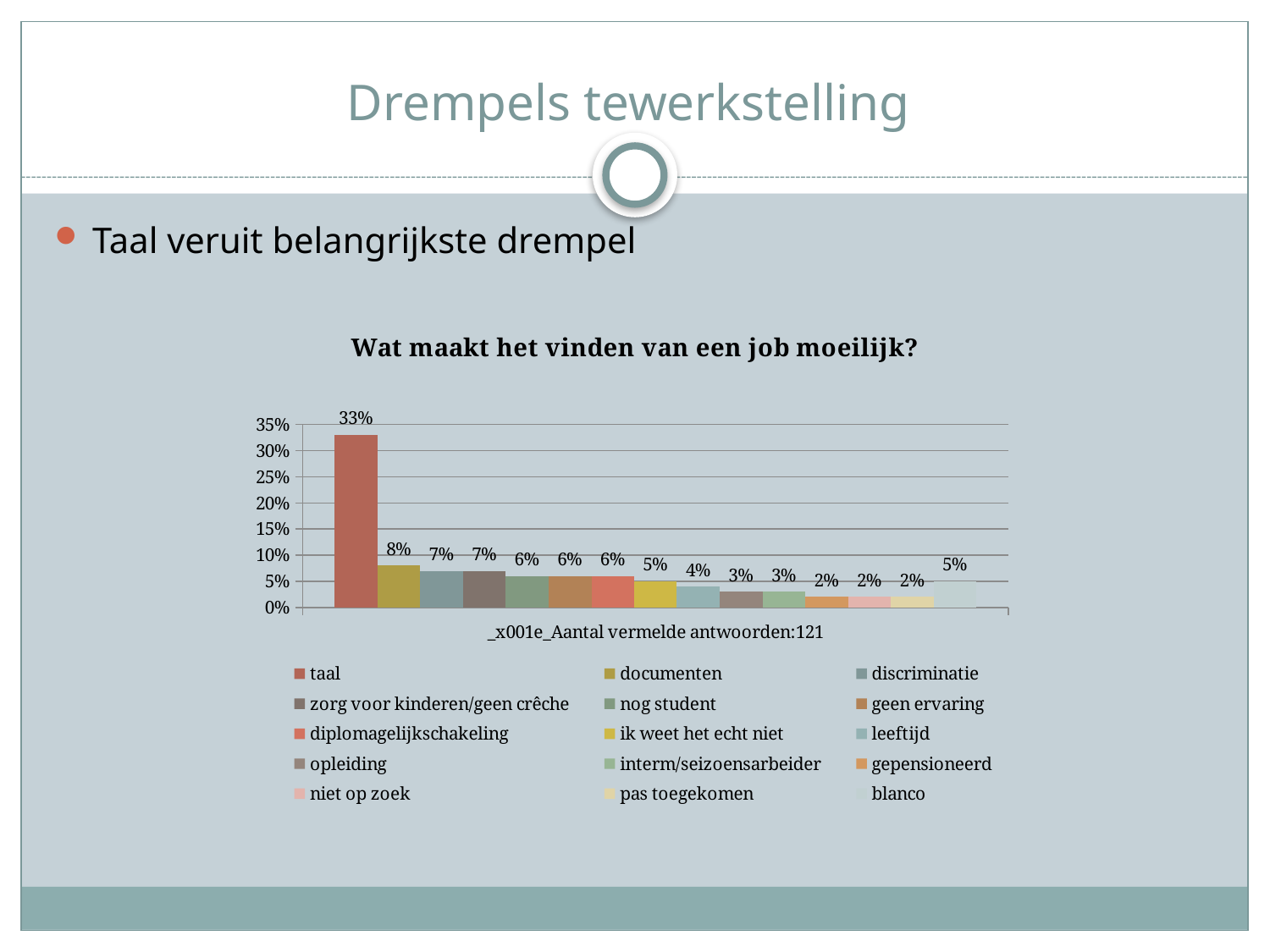
What is the difference between the values for 'taal' and 'documenten'? 25% What kind of chart is shown on the slide? bar chart What percentage is shown for 'taal' in the chart 'Wat maakt het vinden van een job moeilijk?'? 33% What is the difference between the values for 'ik weet het echt niet' and 'gepensioneerd'? 3% What percentage is shown for 'blanco'? 5% How many entries does the legend list? 15 Is the value for 'taal' greater or less than 30%? greater What is the title of the chart? Wat maakt het vinden van een job moeilijk? Which is larger, the value for 'discriminatie' or the value for 'opleiding'? discriminatie Which category has the highest value in the chart? taal What percentage is shown for 'leeftijd'? 4% What percentage is shown for 'documenten'? 8%